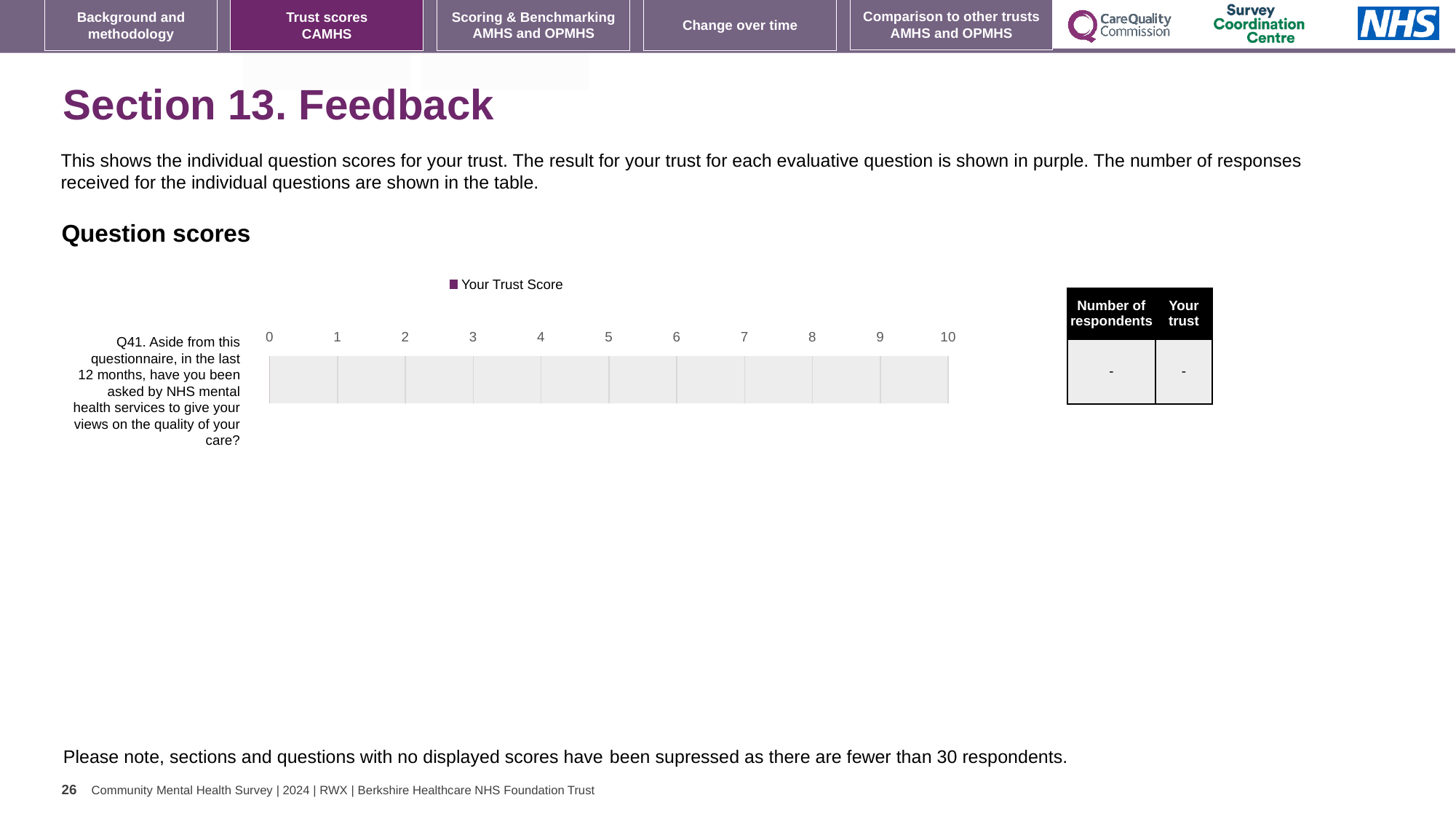
What kind of chart is shown under 'Question scores'? bar chart Is a bar displayed for Q41 on the chart? No What is the maximum value shown on the chart's x axis? 10 What value is shown for 'Your trust' in the table next to the chart? - What value is shown for 'Number of respondents' in the table next to the chart? - How many series does the chart legend list? 1 What is the name of the series in the chart legend? Your Trust Score How many questions (categories) are plotted on the chart? 1